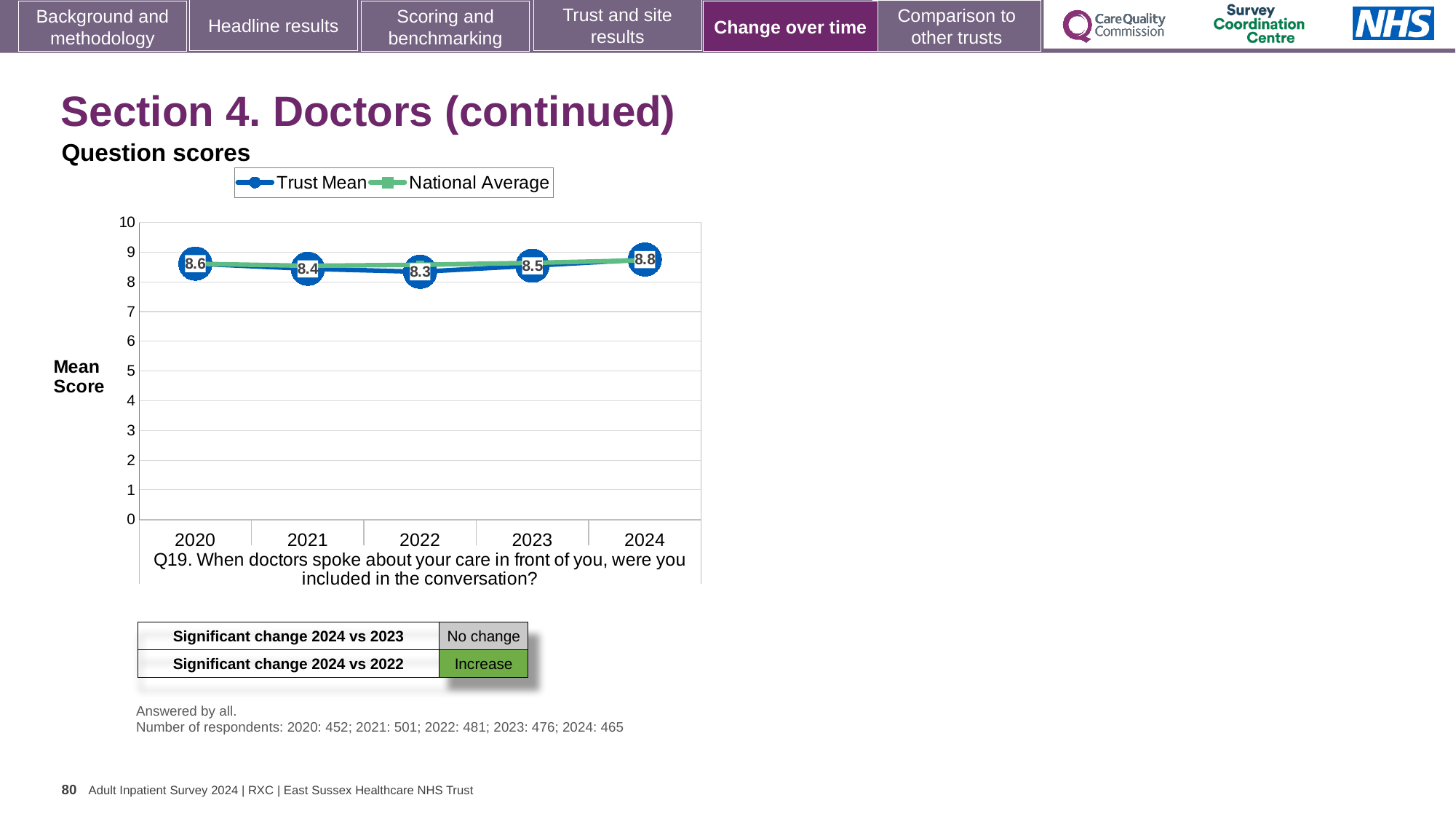
Is the National Average value for 2022 greater or less than 8? greater What is the difference between the Trust Mean score in 2024 and in 2022? 0.5 Does the Trust Mean score rise or fall from 2022 to 2024? rise How many series does the chart legend list? 2 Which is larger, the Trust Mean score for 2021 or for 2023? 2023 In which year is the Trust Mean score highest? 2024 What kind of chart is shown on the slide? line chart What is the Trust Mean score for 2022? 8.3 What is the Trust Mean score for 2020? 8.6 What is the Trust Mean score for 2024? 8.8 How many years are shown on the x axis of the chart? 5 In which year is the Trust Mean score lowest? 2022